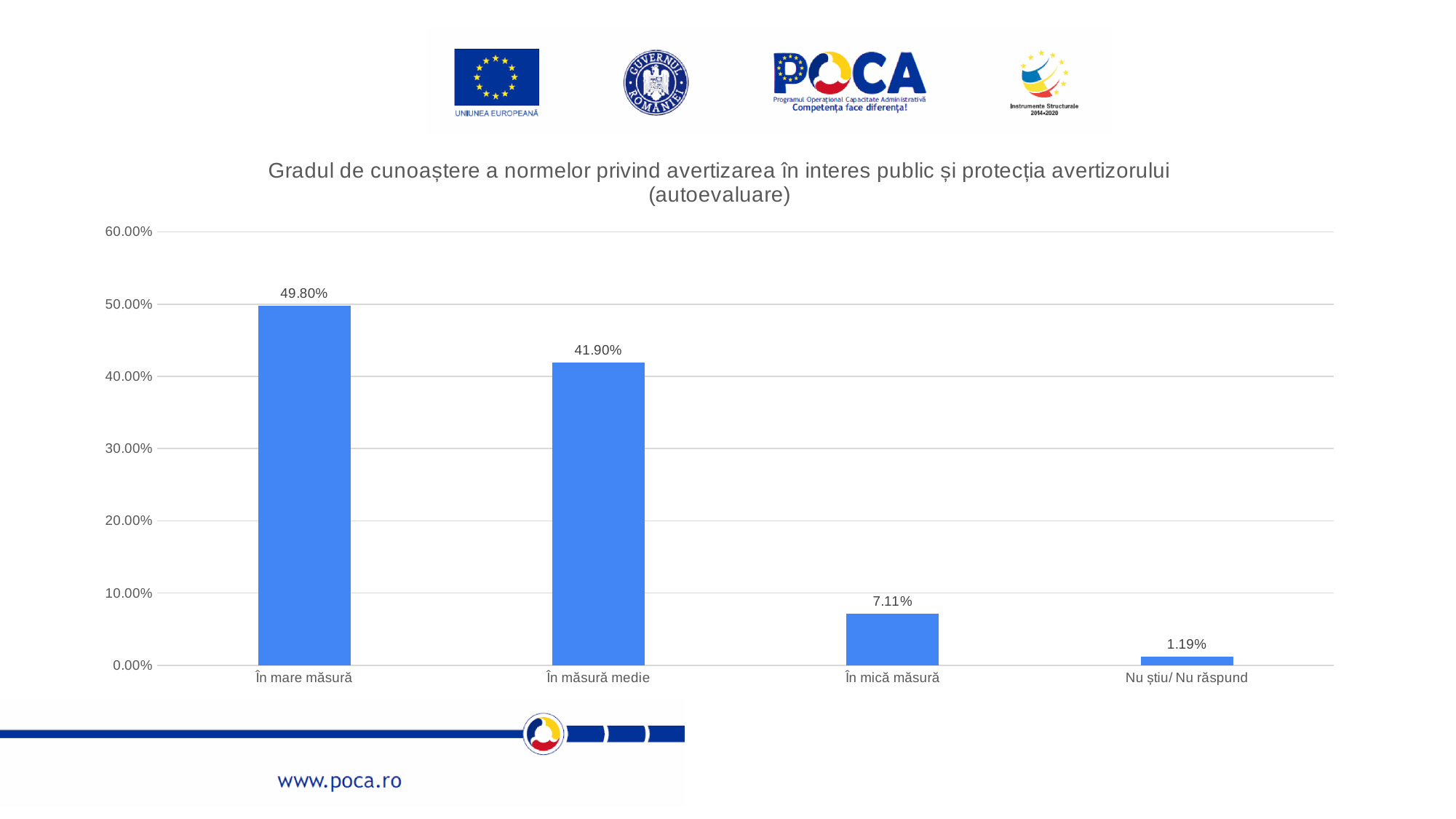
Is the value for "În măsură medie" greater or less than 40.00%? greater Which category has the lowest value? Nu știu/ Nu răspund Which category has the highest value? În mare măsură What is the difference between the values for "În mare măsură" and "În măsură medie"? 7.90% What is the value for "Nu știu/ Nu răspund"? 1.19% What is the value for "În mică măsură"? 7.11% How many categories are shown on the x axis? 4 What is the value for "În mare măsură"? 49.80% Do the values rise or fall from left to right along the x axis? fall What is the value for "În măsură medie"? 41.90% What kind of chart is shown on the slide? bar chart Which is larger, the value for "În mică măsură" or the value for "Nu știu/ Nu răspund"? În mică măsură